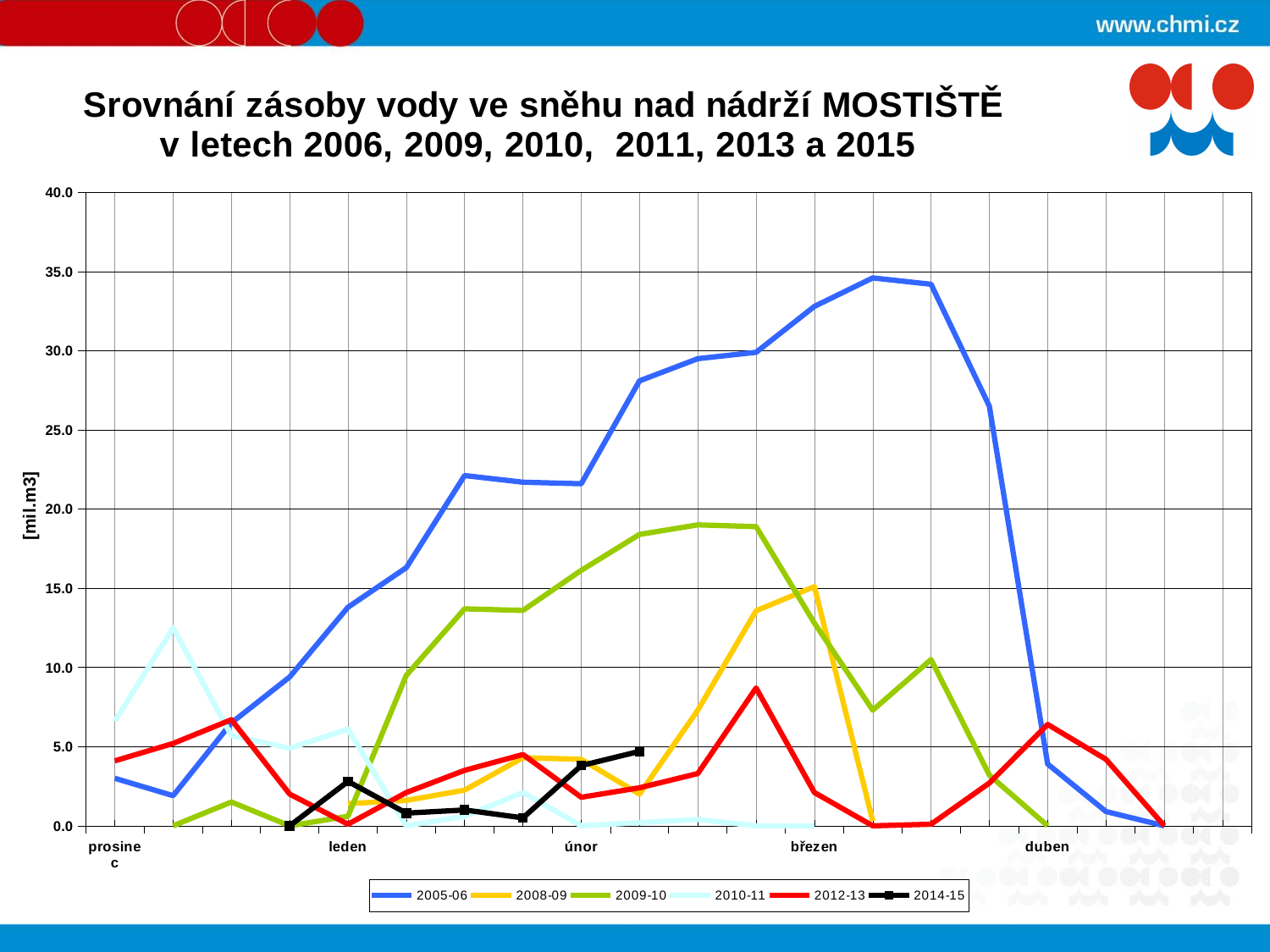
What unit is shown on the y-axis label? [mil.m3] Is the peak value of the 2009-10 series greater or less than 20.0? less How many series does the legend list? 6 Which series reaches the highest value on the chart? 2005-06 Is the peak value of the 2008-09 series greater or less than 10.0? greater Which series has the higher peak, 2005-06 or 2008-09? 2005-06 Is the peak value of the 2005-06 series greater or less than 30.0? greater Which month labels appear on the x axis? prosinec, leden, únor, březen, duben Which series has the higher peak, 2009-10 or 2012-13? 2009-10 Does the 2005-06 series rise or fall between únor and březen? rise What kind of chart is shown on the slide? line chart